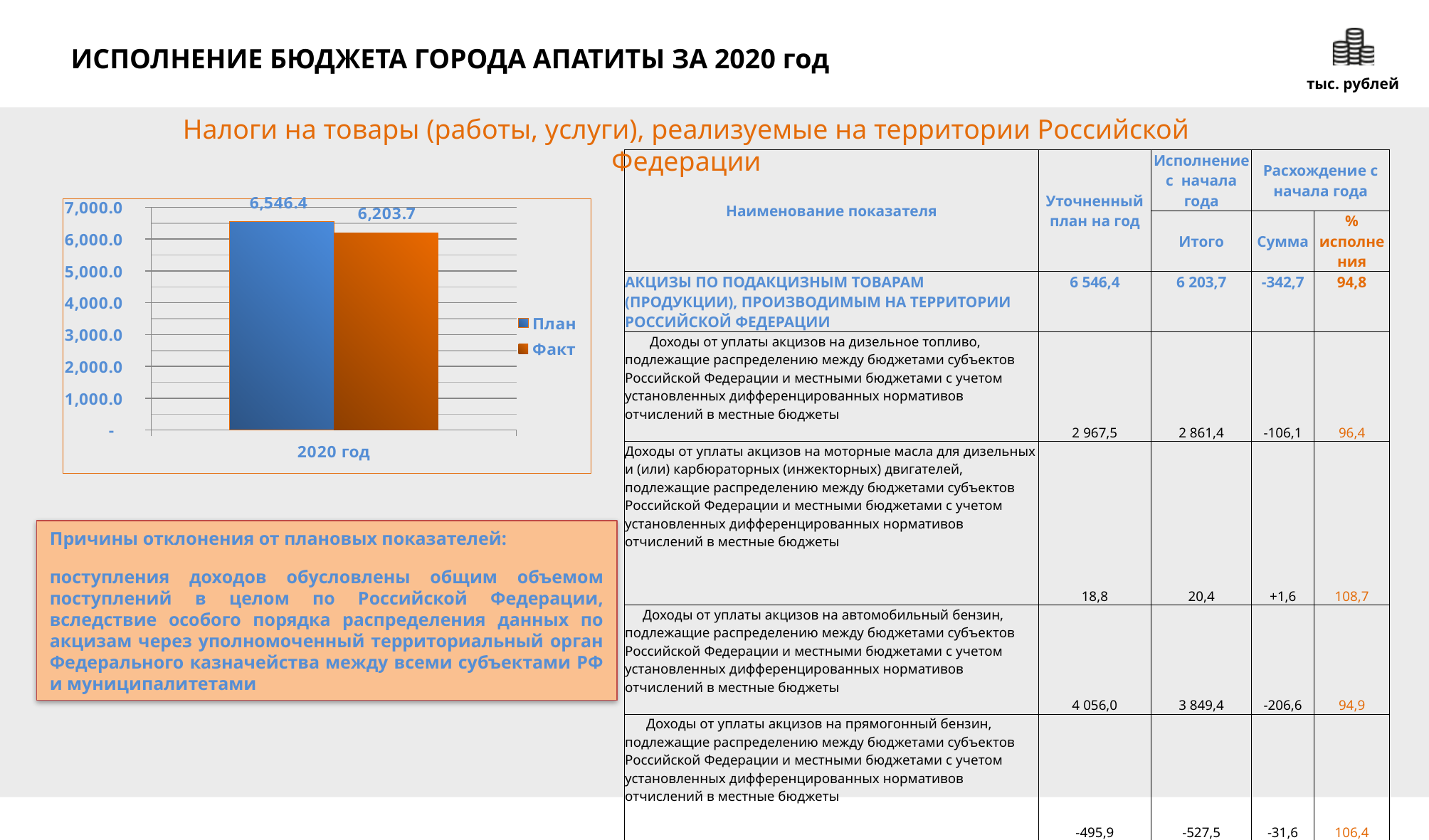
What is the value of the План bar for 2020 год? 6,546.4 Which series has the lowest value in the chart? Факт What is the category label on the x axis of the chart? 2020 год What is the value of the Факт bar for 2020 год? 6,203.7 Is the План value in the chart greater or less than 7,000.0? less How many categories are shown on the x axis of the chart? 1 How many series does the chart legend list? 2 What kind of chart is shown on the slide? bar chart Is the Факт value in the chart greater or less than 6,000.0? greater What colour is the Факт series in the chart? orange What is the difference between the План and Факт values in the chart? 342.7 Which series has the higher value in the chart, План or Факт? План